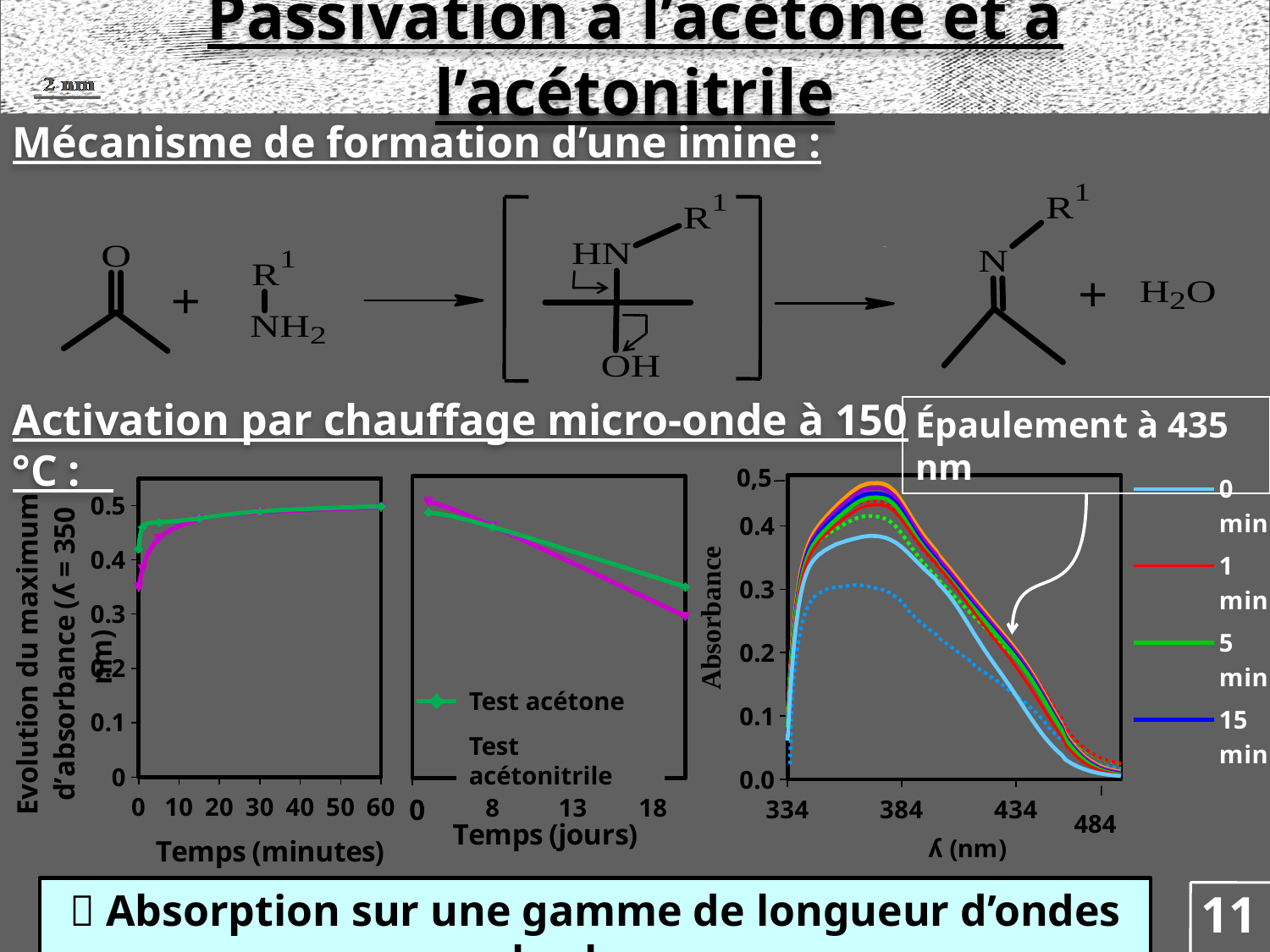
What are the two legend entries shown in the middle chart (Temps (jours))? Test acétone, Test acétonitrile How many series does the legend of the right chart (Absorbance vs λ) list? 4 In the right chart (Absorbance vs λ), is the peak absorbance of the highest curve greater or less than 0.4? greater In the left chart (Temps (minutes)), do the values rise or fall as time increases? rise What kind of chart is the left chart (Temps (minutes))? line chart In the middle chart (Temps (jours)), is the value for Test acétonitrile at the last time point greater or less than 0.4? less In the left chart (Temps (minutes)), is the value for Test acétonitrile at 0 minutes greater or less than 0.4? less How many tick labels are shown on the x axis of the right chart (Absorbance vs λ)? 4 In the middle chart (Temps (jours)), do the values rise or fall as time increases? fall How many series does the legend of the middle chart (Temps (jours)) list? 2 In the middle chart (Temps (jours)), which series has the higher value at the last time point, Test acétone or Test acétonitrile? Test acétone At what wavelength does the annotation on the right chart indicate a shoulder (épaulement)? 435 nm